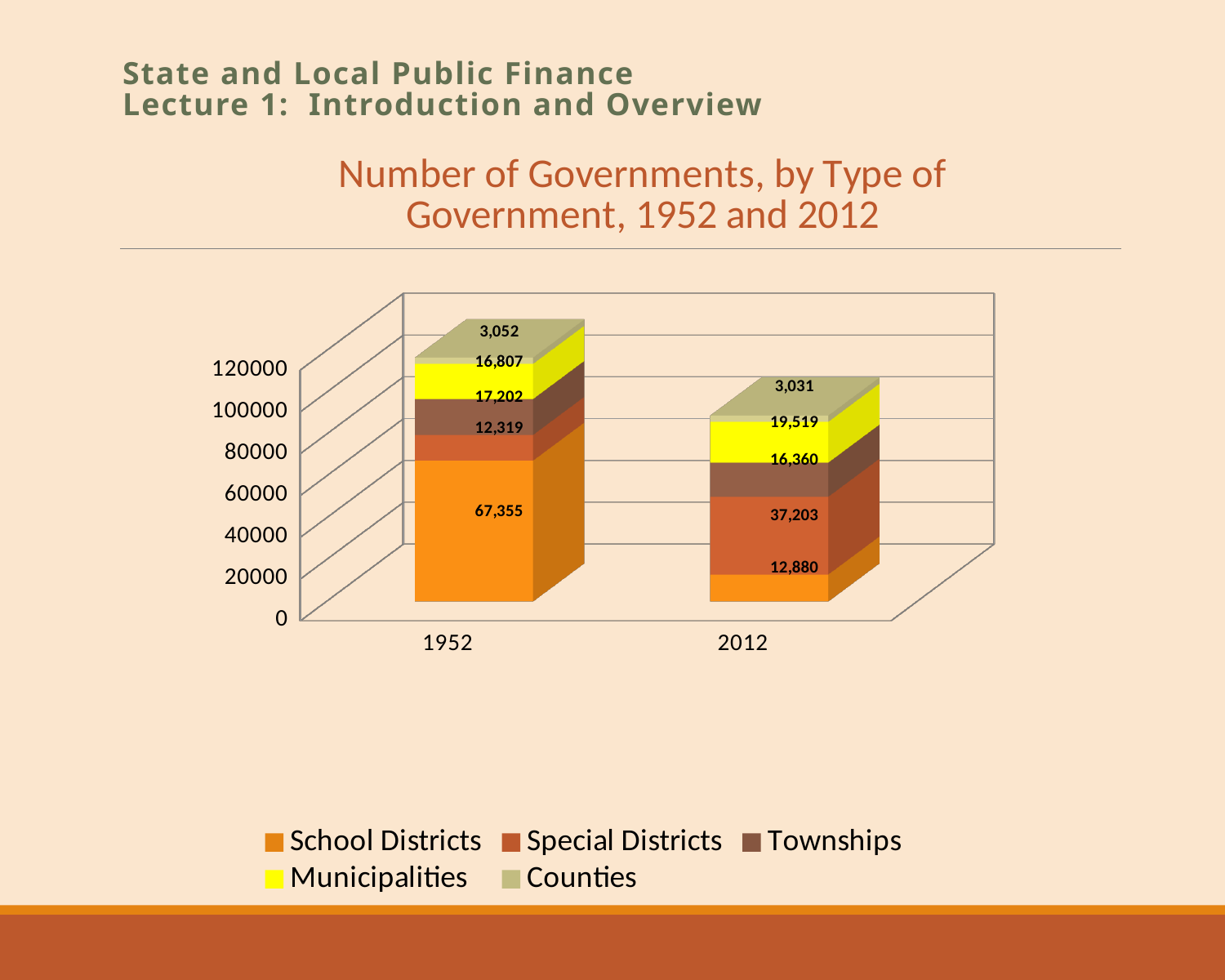
How many series does the legend list? 5 What is the number of School Districts in 1952? 67,355 Which type of government had the smallest number in 1952? Counties What is the total number of governments in the 2012 bar? 88,993 By how much did the number of School Districts fall from 1952 to 2012? 54,475 What is the number of Municipalities in 1952? 16,807 What is the number of Special Districts in 2012? 37,203 Which type of government had the largest number in 2012? Special Districts How many categories (years) are shown on the x axis? 2 Which is larger: the number of Townships in 1952 or in 2012? 1952 What kind of chart is shown on the slide? Stacked bar chart What is the number of Counties in 2012? 3,031